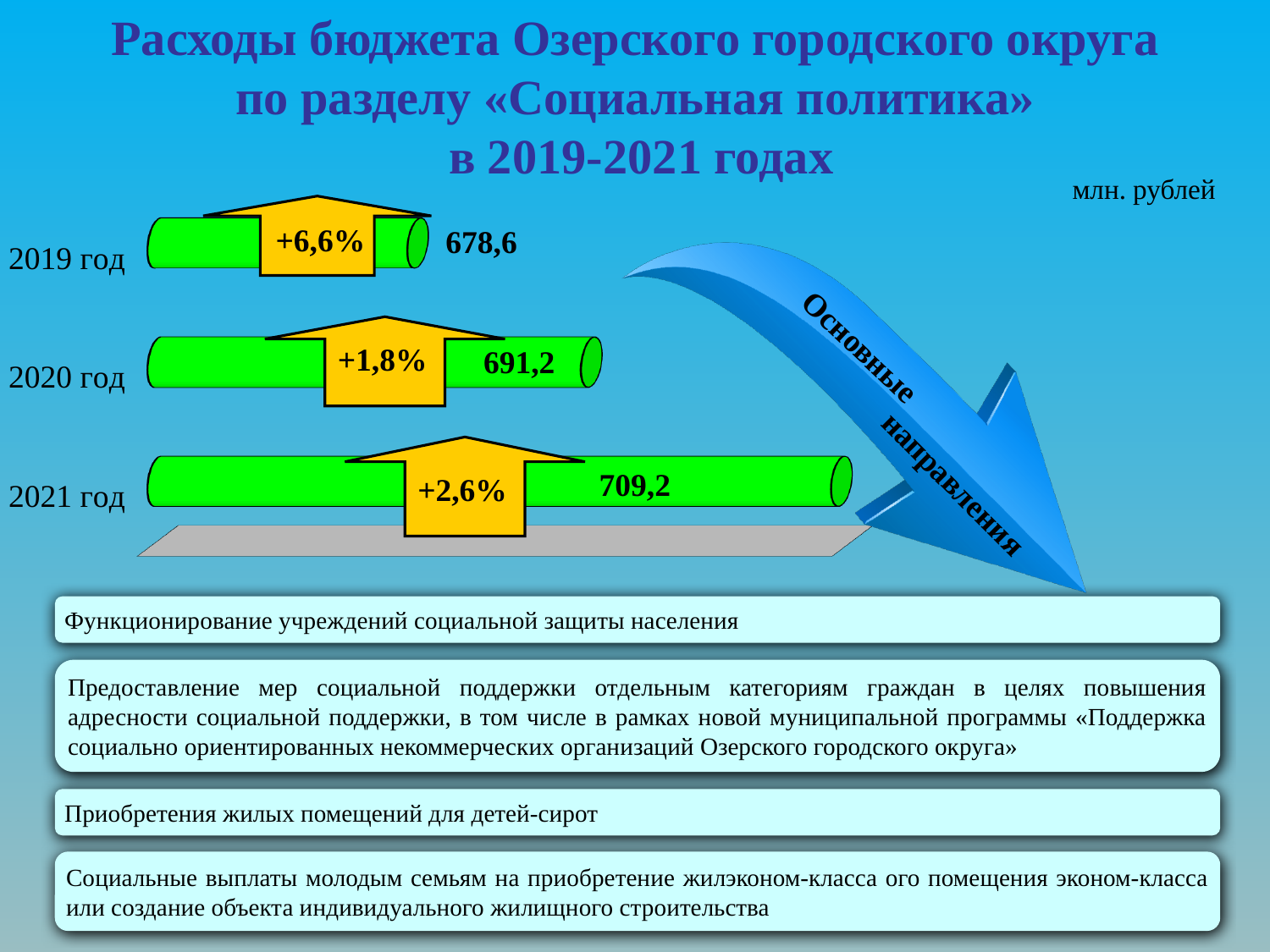
Which year has the highest expenditure value? 2021 год In what units are the chart values given? млн. рублей What is the budget expenditure value shown for 2019 год? 678,6 Which year has the lowest expenditure value? 2019 год What is the difference between the values for 2020 год and 2019 год? 12,6 What is the budget expenditure value shown for 2020 год? 691,2 What percentage growth is shown on the arrow for 2019 год? +6,6% Which is larger, the value for 2020 год or the value for 2019 год? 2020 год What percentage growth is shown on the arrow for 2021 год? +2,6% What is the budget expenditure value shown for 2021 год? 709,2 What is the difference between the values for 2021 год and 2020 год? 18,0 How many years (bars) are shown in the chart? 3